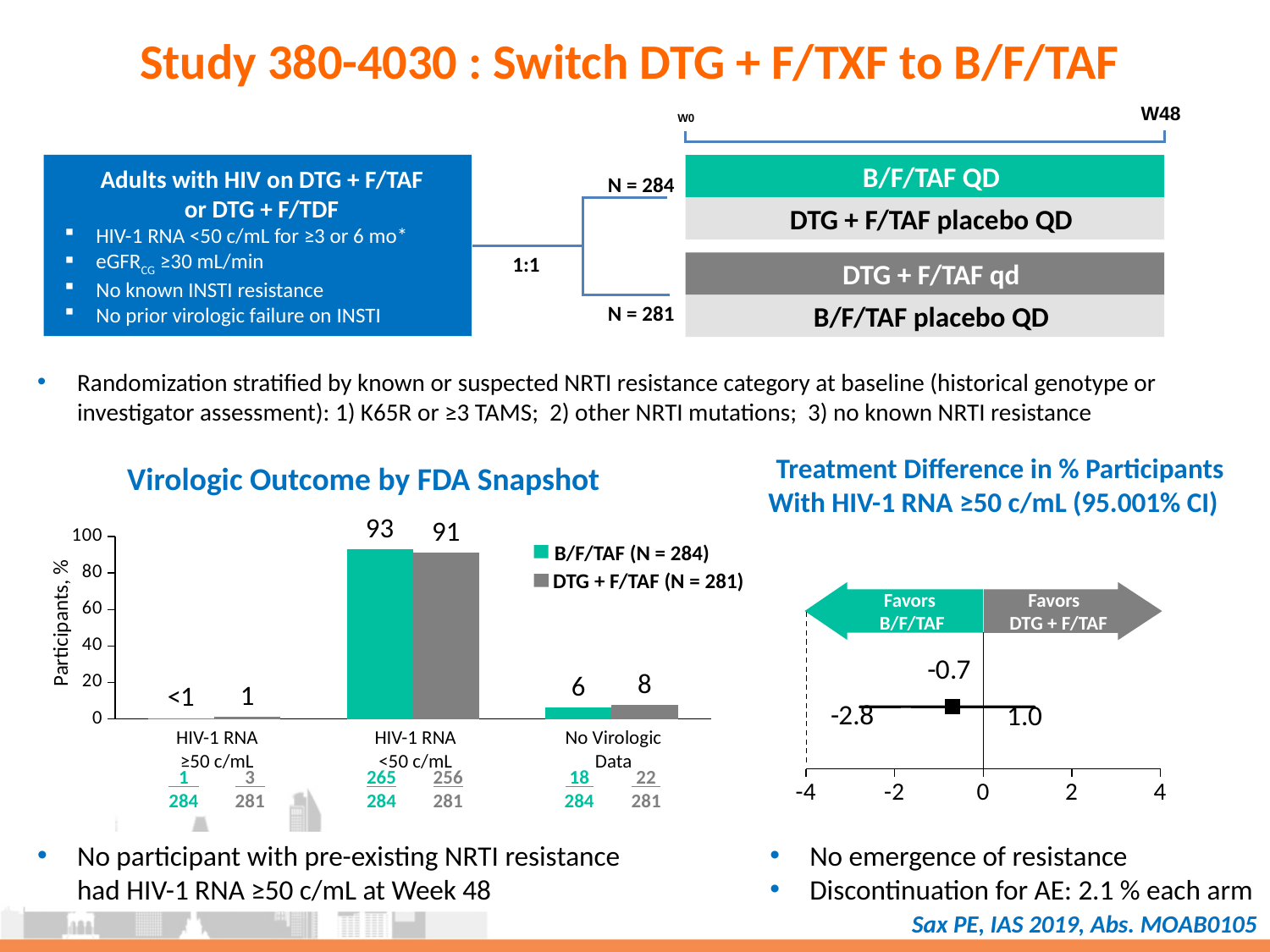
In the 'Virologic Outcome by FDA Snapshot' chart, what is the value for DTG + F/TAF in the 'No Virologic Data' category? 8 In the 'Virologic Outcome by FDA Snapshot' chart, what is the value for B/F/TAF in the 'No Virologic Data' category? 6 In the 'Virologic Outcome by FDA Snapshot' chart, which category has the highest values for both arms? HIV-1 RNA <50 c/mL In the 'Virologic Outcome by FDA Snapshot' chart, what percentage of B/F/TAF participants had HIV-1 RNA <50 c/mL? 93 What type of chart is 'Virologic Outcome by FDA Snapshot'? Bar chart In the 'Virologic Outcome by FDA Snapshot' chart, what is the value for DTG + F/TAF in the 'HIV-1 RNA ≥50 c/mL' category? 1 In the 'Treatment Difference in % Participants With HIV-1 RNA ≥50 c/mL' chart, what is the point estimate of the treatment difference? -0.7 How many series does the legend of the 'Virologic Outcome by FDA Snapshot' chart list? 2 In the 'Virologic Outcome by FDA Snapshot' chart, what percentage of DTG + F/TAF participants had HIV-1 RNA <50 c/mL? 91 In the 'Virologic Outcome by FDA Snapshot' chart, which arm has the higher value for 'No Virologic Data'? DTG + F/TAF In the 'Virologic Outcome by FDA Snapshot' chart, what is the difference between the B/F/TAF and DTG + F/TAF values for HIV-1 RNA <50 c/mL? 2 How many categories are shown on the x axis of the 'Virologic Outcome by FDA Snapshot' chart? 3